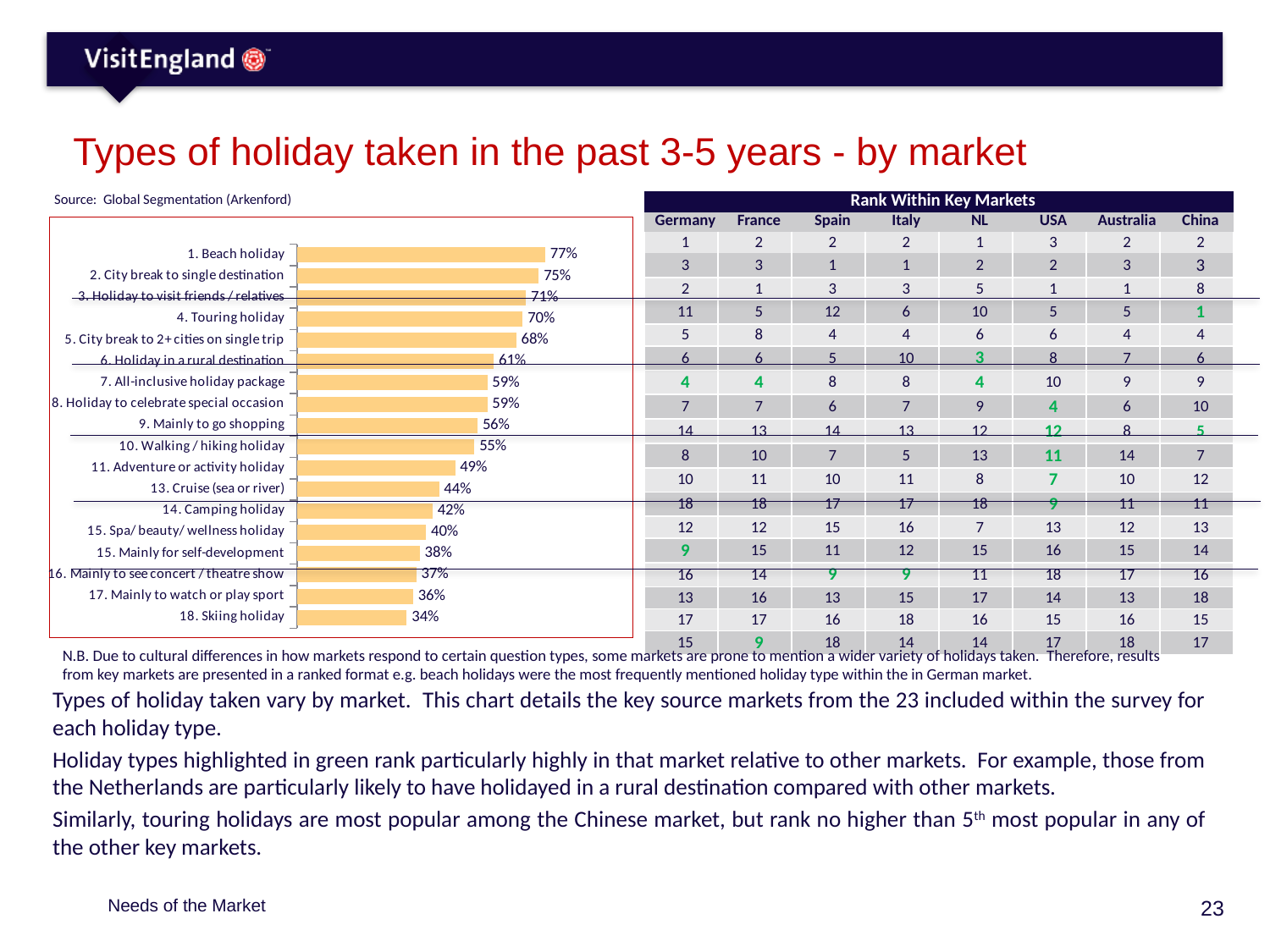
What is the title of the slide containing the chart? Types of holiday taken in the past 3-5 years - by market What is the difference between the values for '1. Beach holiday' and '18. Skiing holiday'? 43% Which holiday type has the highest percentage in the bar chart? 1. Beach holiday What is the value for '10. Walking / hiking holiday'? 55% Do the bar values rise or fall going down the chart from '1. Beach holiday' to '18. Skiing holiday'? Fall How many holiday types (bars) are plotted in the bar chart? 18 What type of chart is used to show the types of holiday taken? Bar chart What percentage is shown for '13. Cruise (sea or river)'? 44% Which holiday type has the lowest percentage in the bar chart? 18. Skiing holiday Which is larger: the value for '11. Adventure or activity holiday' or '14. Camping holiday'? 11. Adventure or activity holiday What percentage is shown for '1. Beach holiday'? 77% What is the difference between '4. Touring holiday' and '6. Holiday in a rural destination'? 9%